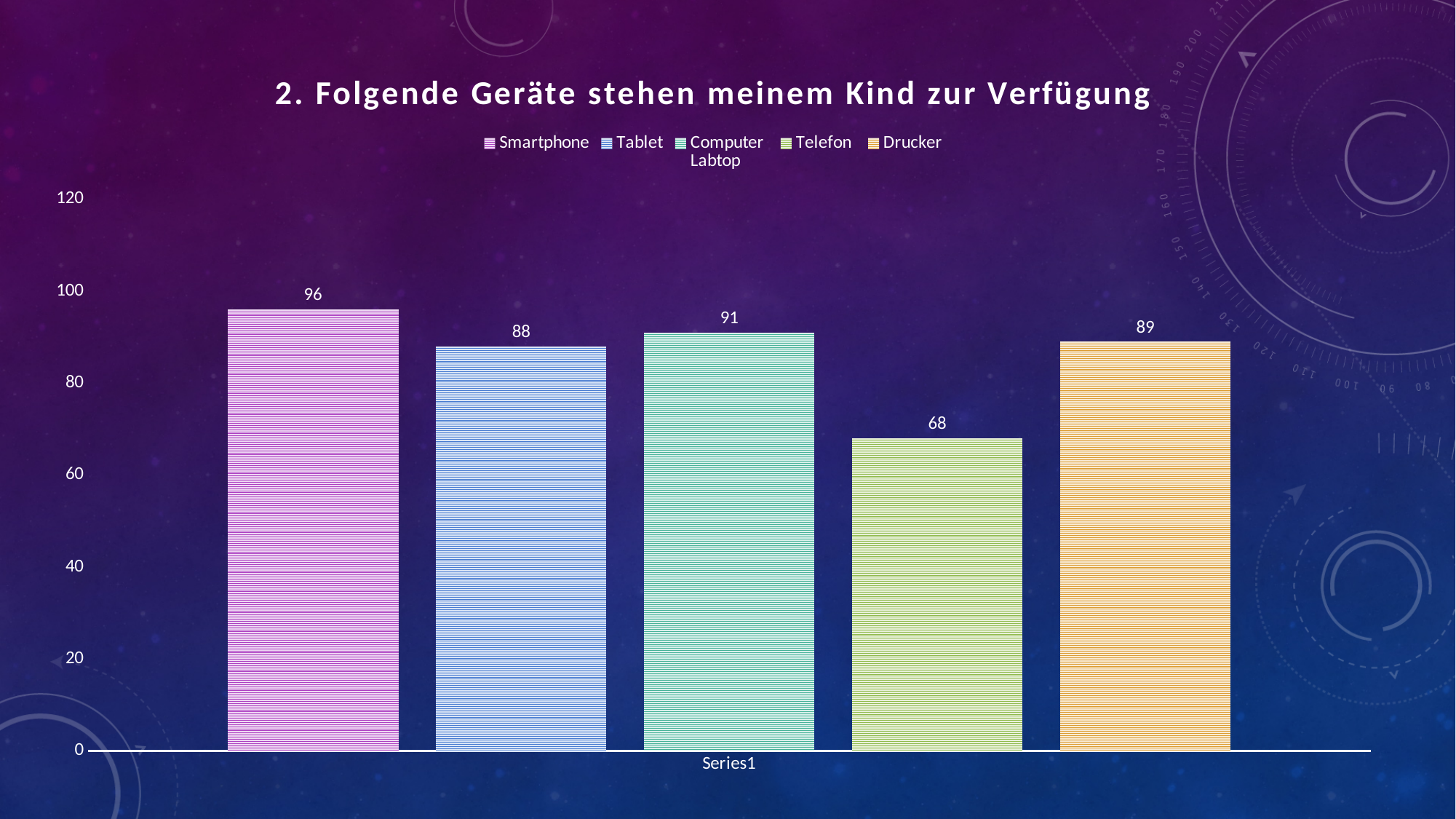
What is the value for Drucker? 89 How many series does the legend list? 5 What is the value for Tablet? 88 What is the value for Computer Labtop? 91 Which device has the highest value? Smartphone What is the difference between the values for Smartphone and Telefon? 28 What is the value for Smartphone? 96 Which is larger, the value for Computer Labtop or the value for Tablet? Computer Labtop What is the title of the chart? 2. Folgende Geräte stehen meinem Kind zur Verfügung What kind of chart is shown on the slide? Bar chart What is the value for Telefon? 68 Which device has the lowest value? Telefon